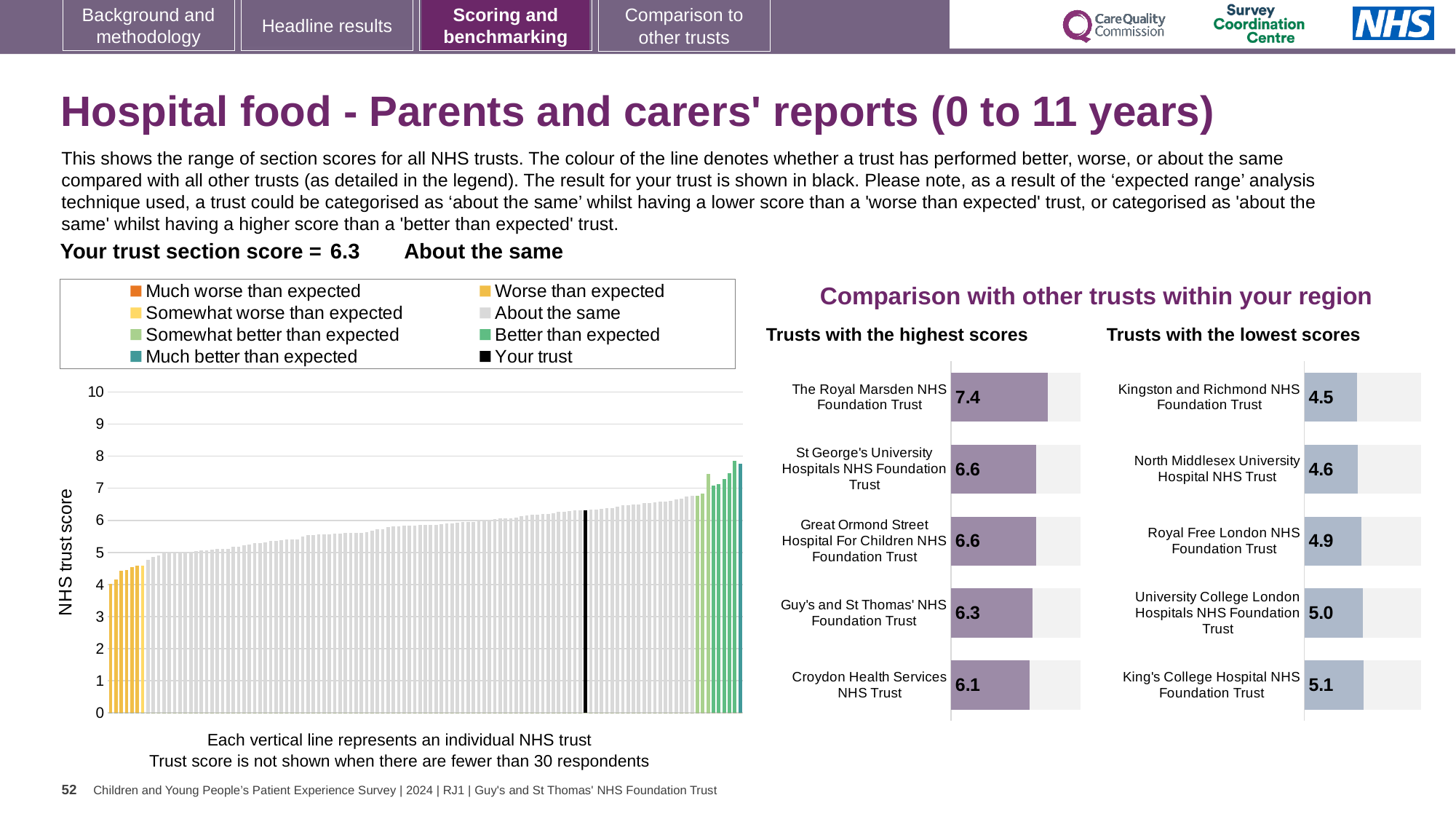
How many trusts are shown in the 'Trusts with the highest scores' chart? 5 In the 'Trusts with the highest scores' chart, what is the score for The Royal Marsden NHS Foundation Trust? 7.4 In the 'Trusts with the highest scores' chart, what is the difference between the scores of The Royal Marsden NHS Foundation Trust and Croydon Health Services NHS Trust? 1.3 In the 'Trusts with the lowest scores' chart, which has the larger score: Royal Free London NHS Foundation Trust or University College London Hospitals NHS Foundation Trust? University College London Hospitals NHS Foundation Trust In the 'Trusts with the lowest scores' chart, which trust has the lowest score? Kingston and Richmond NHS Foundation Trust In the 'NHS trust score' chart on the left, what colour is the bar for 'Your trust'? black In the 'Trusts with the lowest scores' chart, what is the score for Kingston and Richmond NHS Foundation Trust? 4.5 How many entries does the legend of the 'NHS trust score' chart on the left list? 8 What kind of chart is the 'NHS trust score' chart on the left of the slide? bar chart In the 'NHS trust score' chart on the left, is the value of the tallest bar greater or less than 7? greater In the 'NHS trust score' chart on the left, do the values rise or fall from left to right? rise In the 'Trusts with the highest scores' chart, which trust has the highest score? The Royal Marsden NHS Foundation Trust